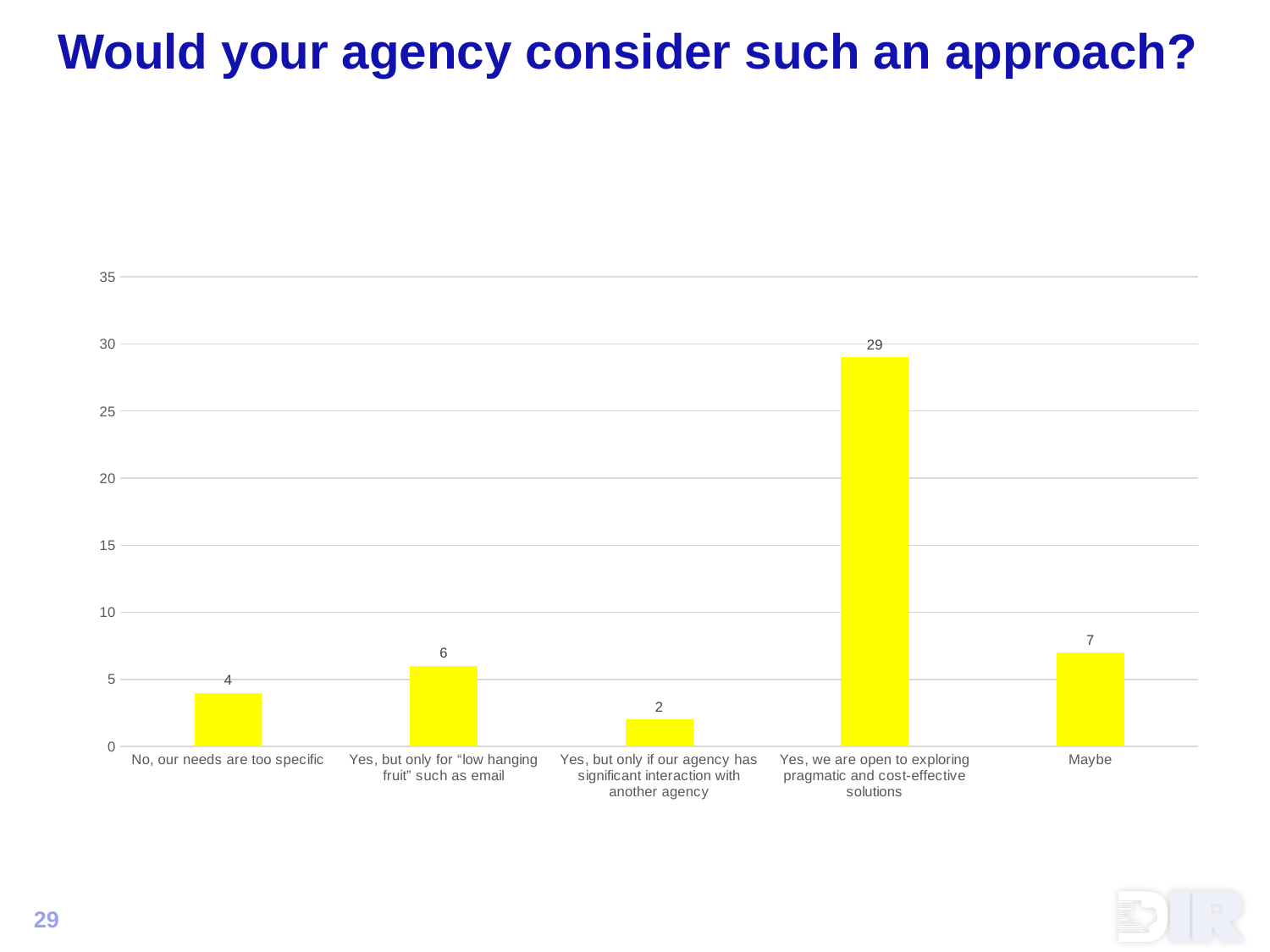
Which category has the lowest value? Yes, but only if our agency has significant interaction with another agency What is the value for "Maybe"? 7 What is the value for "No, our needs are too specific"? 4 Is the value for "Yes, we are open to exploring pragmatic and cost-effective solutions" greater or less than 25? greater Which is larger, the value for "Maybe" or the value for "Yes, but only for “low hanging fruit” such as email"? Maybe How many categories are shown on the chart? 5 What is the difference between the value for "Yes, we are open to exploring pragmatic and cost-effective solutions" and the value for "Maybe"? 22 What is the difference between the value for "Yes, but only for “low hanging fruit” such as email" and the value for "No, our needs are too specific"? 2 Which category has the highest value? Yes, we are open to exploring pragmatic and cost-effective solutions What kind of chart is shown on the slide? bar chart What is the value for "Yes, but only if our agency has significant interaction with another agency"? 2 What is the title of the slide? Would your agency consider such an approach?